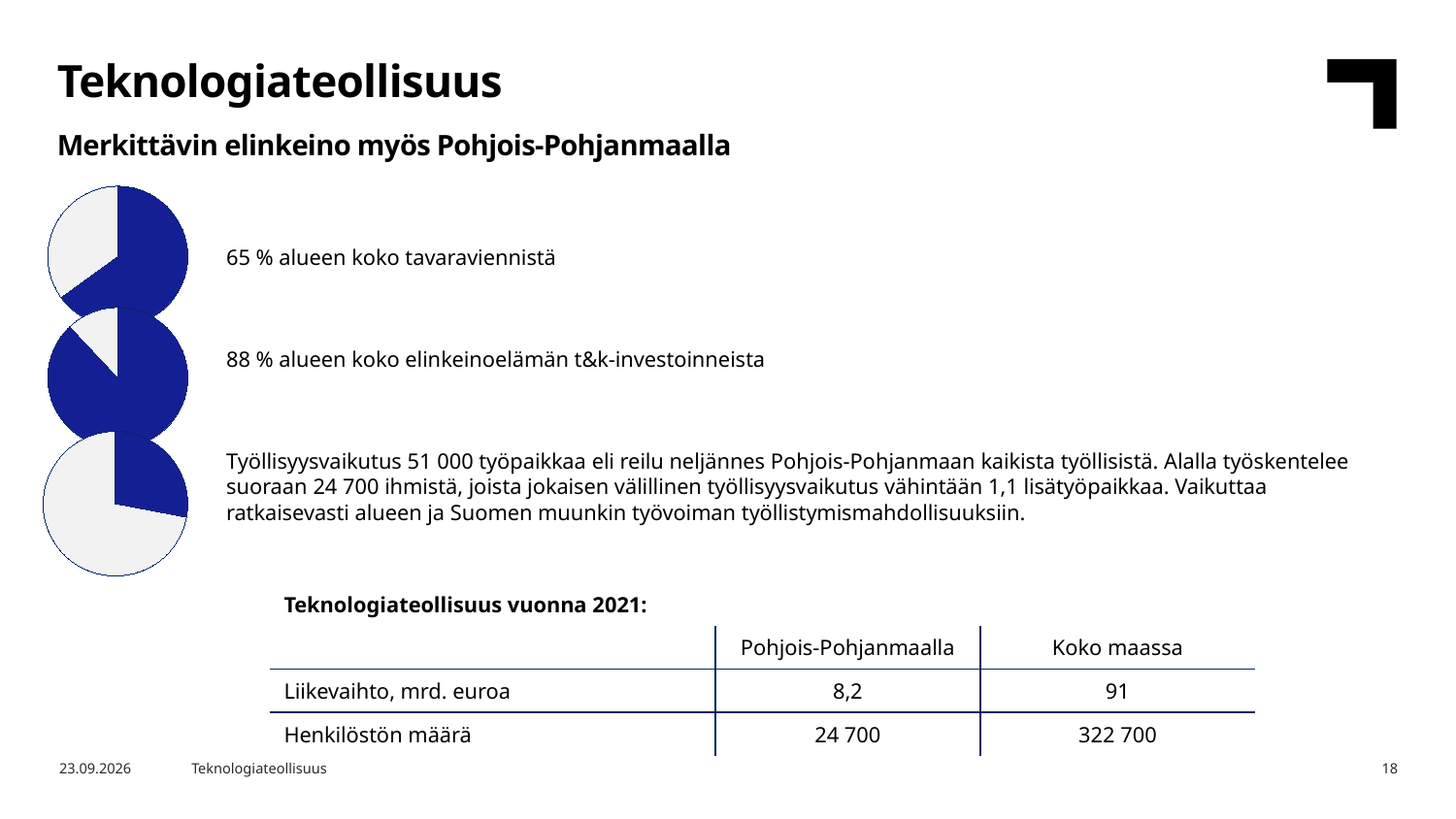
What kind of charts are shown on the left side of the slide? Pie charts What is the title of the slide containing the pie charts? Teknologiateollisuus Which of the three pie charts has the smallest dark blue (filled) share? The bottom one (employment effect) According to the text next to the top pie chart, what share of the region's total goods exports does the technology industry account for? 65 % Is the filled share of the middle pie chart greater or less than 75%? greater Is the filled share of the bottom pie chart greater or less than 50%? less What colour is used for the highlighted slice in the pie charts? Dark blue How many pie charts are on the slide? 3 Is the dark blue share in the top pie chart larger or smaller than the dark blue share in the bottom pie chart? Larger What is the difference in percentage points between the shares shown for the middle pie chart (88 %) and the top pie chart (65 %)? 23 percentage points Which of the three pie charts has the largest dark blue (filled) share? The middle one (88 % of R&D investments) According to the text next to the middle pie chart, what share of the region's business R&D investments does the technology industry account for? 88 %